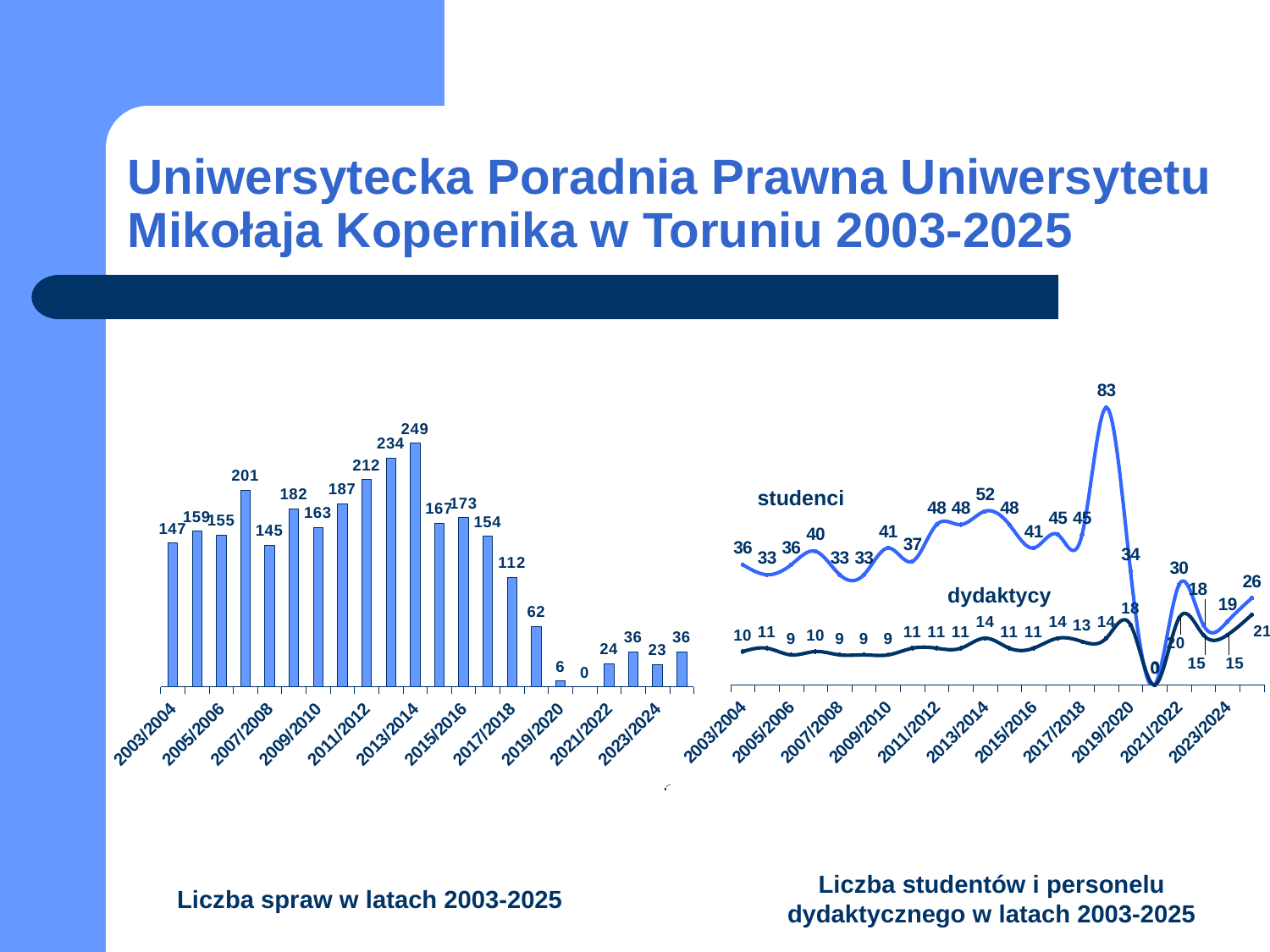
In the left chart 'Liczba spraw w latach 2003-2025', what is the lowest value shown? 0 In the left chart 'Liczba spraw w latach 2003-2025', what is the difference between the value for 2013/2014 and the value for 2003/2004? 102 In the right chart 'Liczba studentów i personelu dydaktycznego w latach 2003-2025', what are the names of the two series? studenci and dydaktycy In the right chart 'Liczba studentów i personelu dydaktycznego w latach 2003-2025', what is the highest value of the 'studenci' series? 83 In the left chart 'Liczba spraw w latach 2003-2025', do the values rise or fall from 2013/2014 to 2020/2021? fall How many series are plotted in the right chart 'Liczba studentów i personelu dydaktycznego w latach 2003-2025'? 2 In the left chart 'Liczba spraw w latach 2003-2025', what is the value for 2003/2004? 147 In the left chart 'Liczba spraw w latach 2003-2025', which year has the highest value? 2013/2014 What kind of chart is the right chart, 'Liczba studentów i personelu dydaktycznego w latach 2003-2025'? line chart In the left chart 'Liczba spraw w latach 2003-2025', how many bars are plotted? 22 In the left chart 'Liczba spraw w latach 2003-2025', what is the highest value shown? 249 What kind of chart is the left chart, 'Liczba spraw w latach 2003-2025'? bar chart